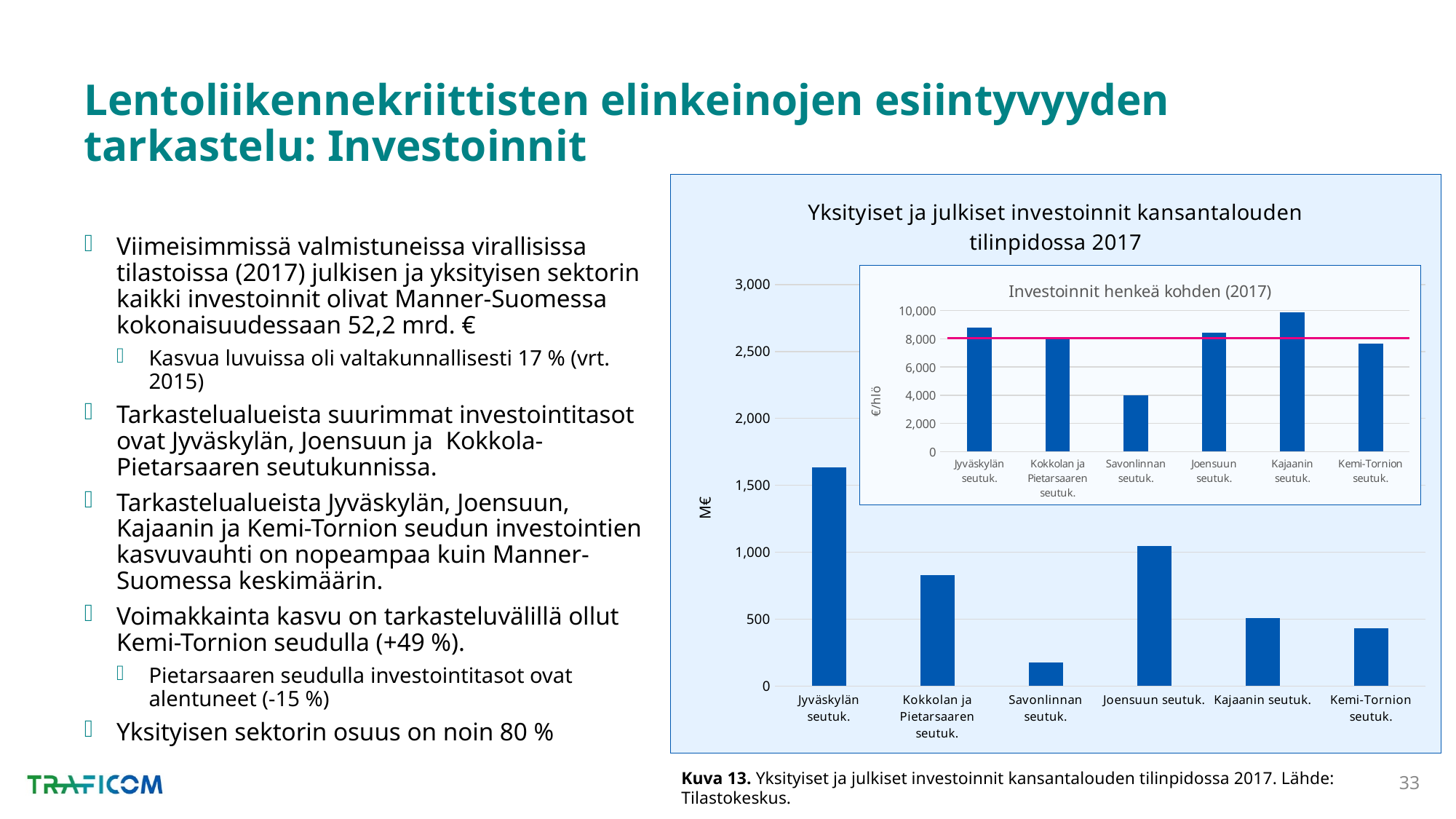
In the main chart 'Yksityiset ja julkiset investoinnit kansantalouden tilinpidossa 2017', which is larger: Kajaanin seutuk. or Kemi-Tornion seutuk.? Kajaanin seutuk. What is the y-axis label of the inset chart 'Investoinnit henkeä kohden (2017)'? €/hlö In the inset chart 'Investoinnit henkeä kohden (2017)', is the value for Savonlinnan seutuk. greater or less than 6,000? less In the main chart 'Yksityiset ja julkiset investoinnit kansantalouden tilinpidossa 2017', is the value for Savonlinnan seutuk. greater or less than 500? less In the main chart 'Yksityiset ja julkiset investoinnit kansantalouden tilinpidossa 2017', is the value for Jyväskylän seutuk. greater or less than 1,500? greater In the main chart 'Yksityiset ja julkiset investoinnit kansantalouden tilinpidossa 2017', which region has the lowest value? Savonlinnan seutuk. What kind of chart is the main chart 'Yksityiset ja julkiset investoinnit kansantalouden tilinpidossa 2017'? bar chart In the inset chart 'Investoinnit henkeä kohden (2017)', which region has the lowest value? Savonlinnan seutuk. How many regions are shown in the main chart 'Yksityiset ja julkiset investoinnit kansantalouden tilinpidossa 2017'? 6 In the inset chart 'Investoinnit henkeä kohden (2017)', which region has the highest value? Kajaanin seutuk. In the main chart 'Yksityiset ja julkiset investoinnit kansantalouden tilinpidossa 2017', which region has the highest value? Jyväskylän seutuk.